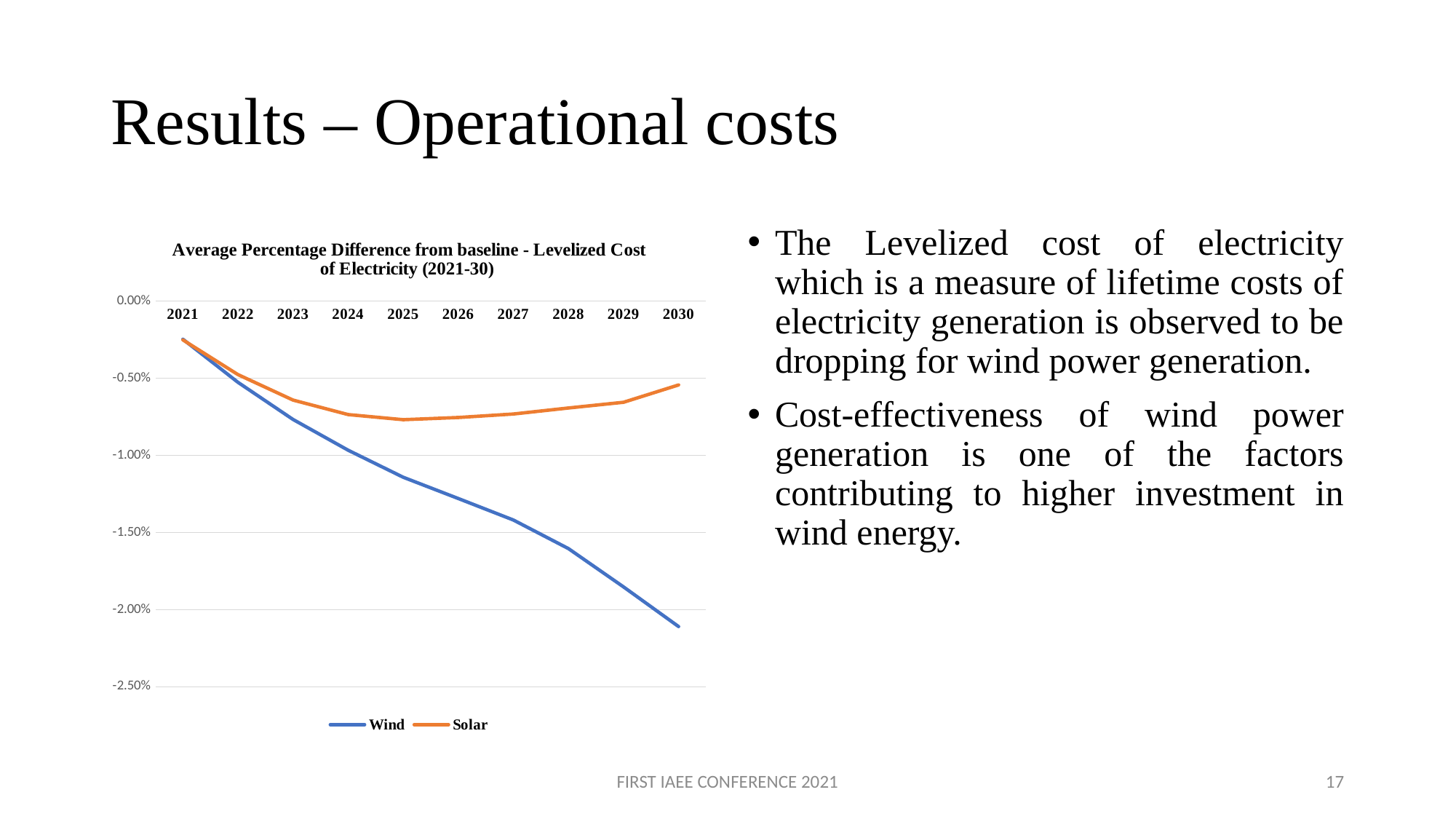
In 2030, which series has the higher value, Wind or Solar? Solar Does the Wind series rise or fall from 2021 to 2030? Fall Which colour is used for the Solar series? Orange In which year does the Wind series reach its lowest value? 2030 Is the value for Solar in 2025 greater or less than -1.00%? greater Is the value for Wind in 2030 greater or less than -2.00%? less Is the value for Wind in 2028 greater or less than -1.50%? less How many years are plotted along the x axis? 10 What is the title of the chart? Average Percentage Difference from baseline - Levelized Cost of Electricity (2021-30) How many series does the legend list? 2 What kind of chart is shown on the slide? Line chart